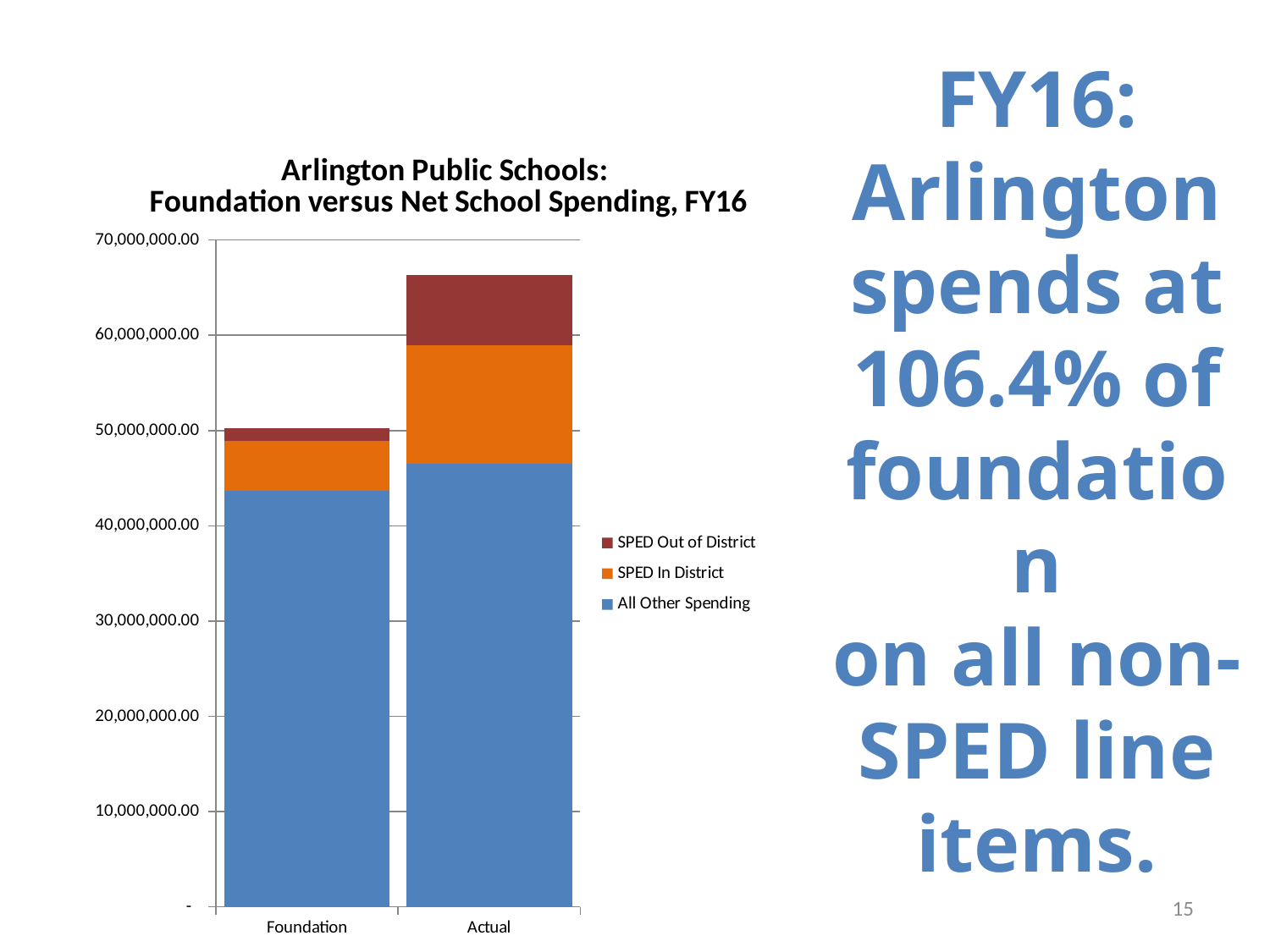
What is the title of the chart? Arlington Public Schools: Foundation versus Net School Spending, FY16 Which series is shown in blue in the chart? All Other Spending Is the All Other Spending value for Foundation greater or less than 50,000,000.00? less How many series does the chart's legend list? 3 Is the All Other Spending value for Actual greater or less than 40,000,000.00? greater Is the total of the Foundation bar greater or less than 60,000,000.00? less How many categories are shown on the x axis of the chart? 2 Which category has the shorter stacked bar? Foundation Which category has the taller stacked bar, Foundation or Actual? Actual Which category has the larger SPED In District segment, Foundation or Actual? Actual What kind of chart is shown on the slide? Stacked bar chart